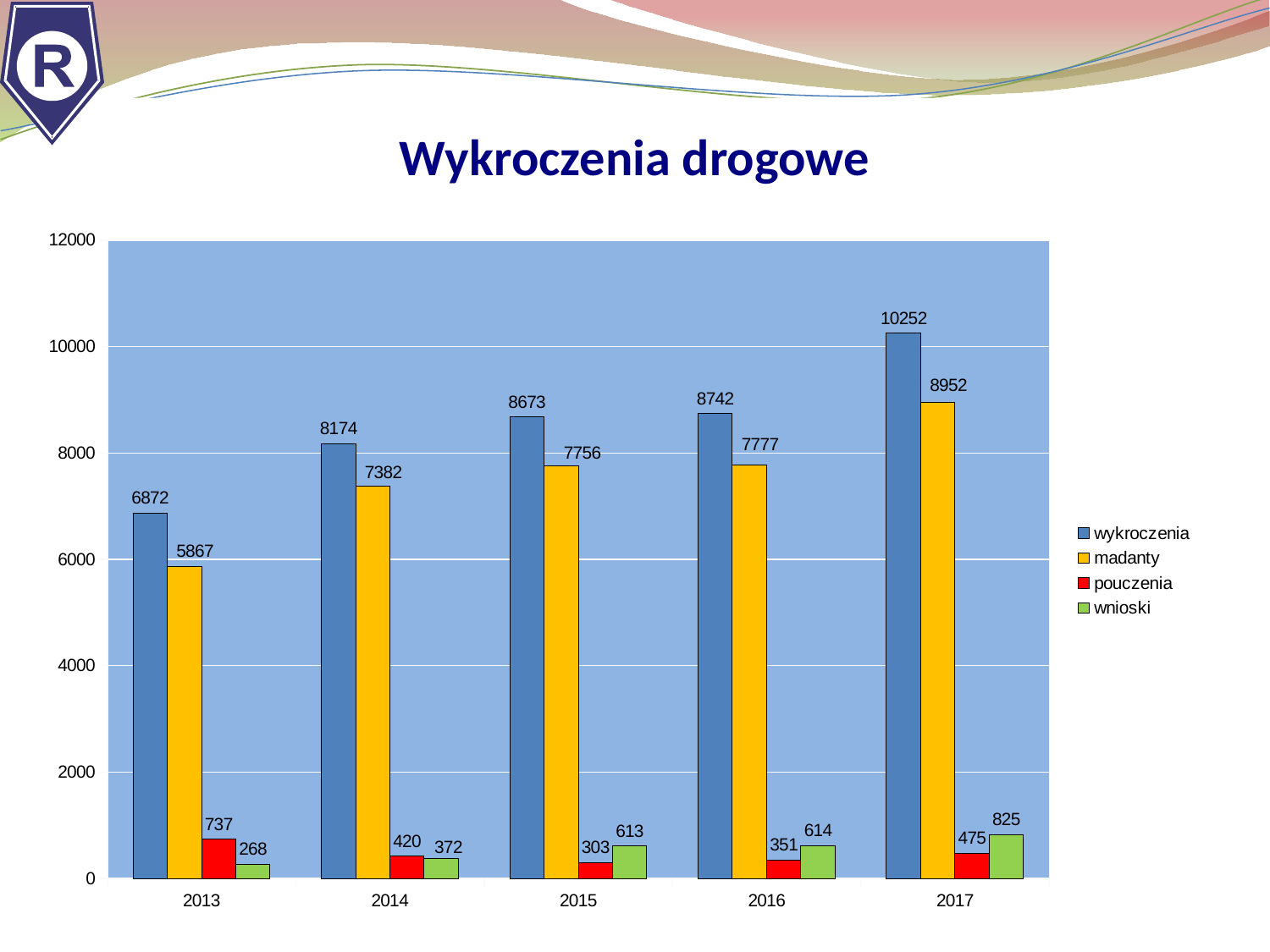
Which year has the highest value for wykroczenia? 2017 Which is larger in 2014: pouczenia or wnioski? pouczenia What is the difference between wykroczenia and madanty in 2015? 917 Which year has the lowest value for wnioski? 2013 How many series does the legend list? 4 What is the value of wnioski for 2016? 614 What is the value of wykroczenia for 2017? 10252 Is the value for madanty in 2017 greater or less than 8000? greater What is the value of pouczenia for 2013? 737 How many years are shown on the x axis? 5 What kind of chart is shown on the slide? bar chart What is the value of madanty for 2014? 7382